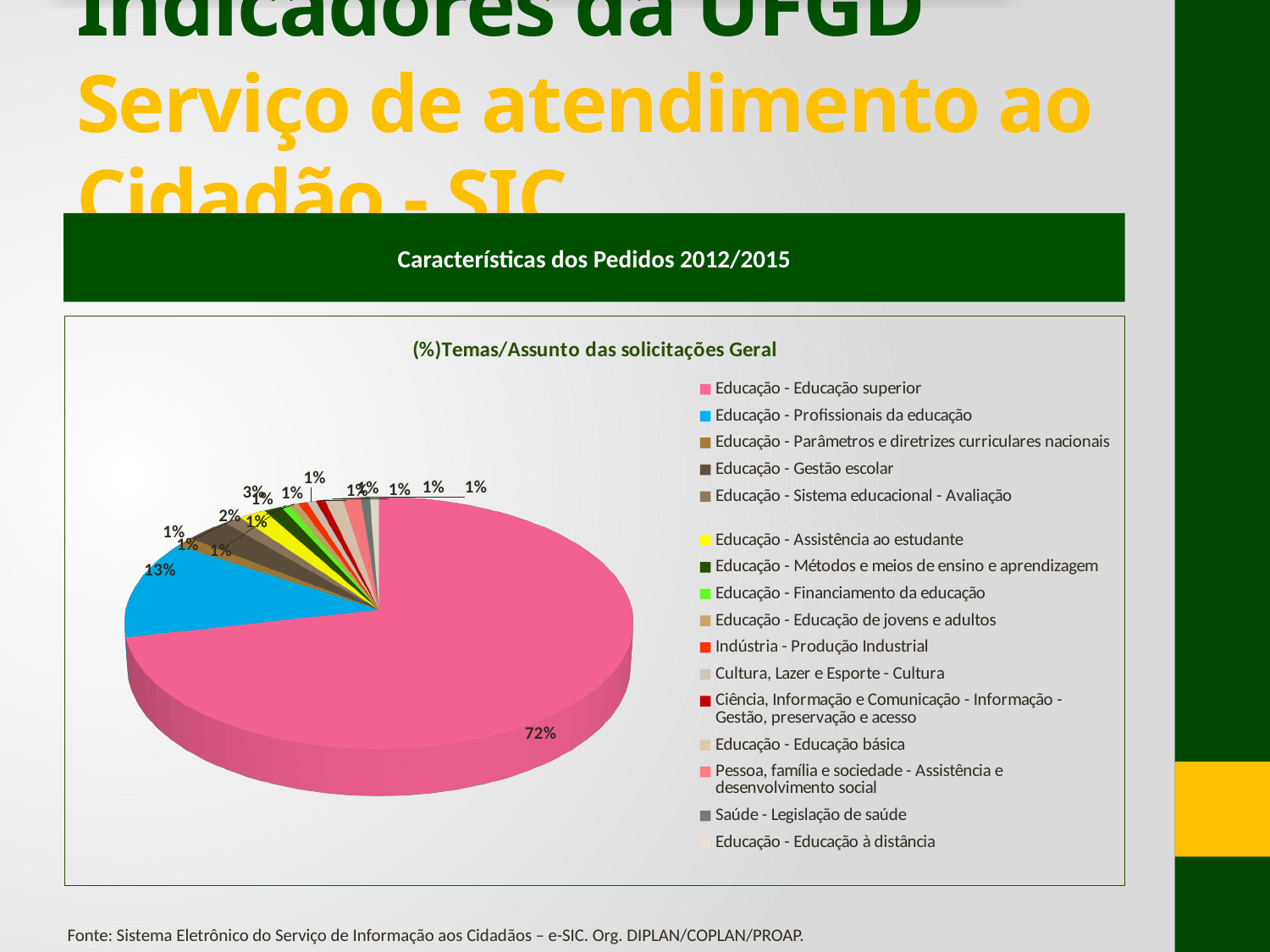
What is the title of the chart? (%)Temas/Assunto das solicitações Geral Is the share for 'Educação - Educação superior' greater or less than 50%? greater What is the difference in percentage points between 'Educação - Educação superior' and 'Educação - Profissionais da educação'? 59 percentage points What percentage of requests is for 'Educação - Profissionais da educação'? 13% What share of the pie do 'Educação - Educação superior' and 'Educação - Profissionais da educação' make up together? 85% What percentage of requests is for 'Educação - Educação superior'? 72% Is the share for 'Educação - Profissionais da educação' greater or less than 20%? less How many categories does the legend list? 16 What kind of chart is shown on the slide? pie chart Which category has the largest slice of the pie? Educação - Educação superior What colour is the largest slice of the pie? pink Which is larger: the slice for 'Educação - Educação superior' or the slice for 'Educação - Profissionais da educação'? Educação - Educação superior